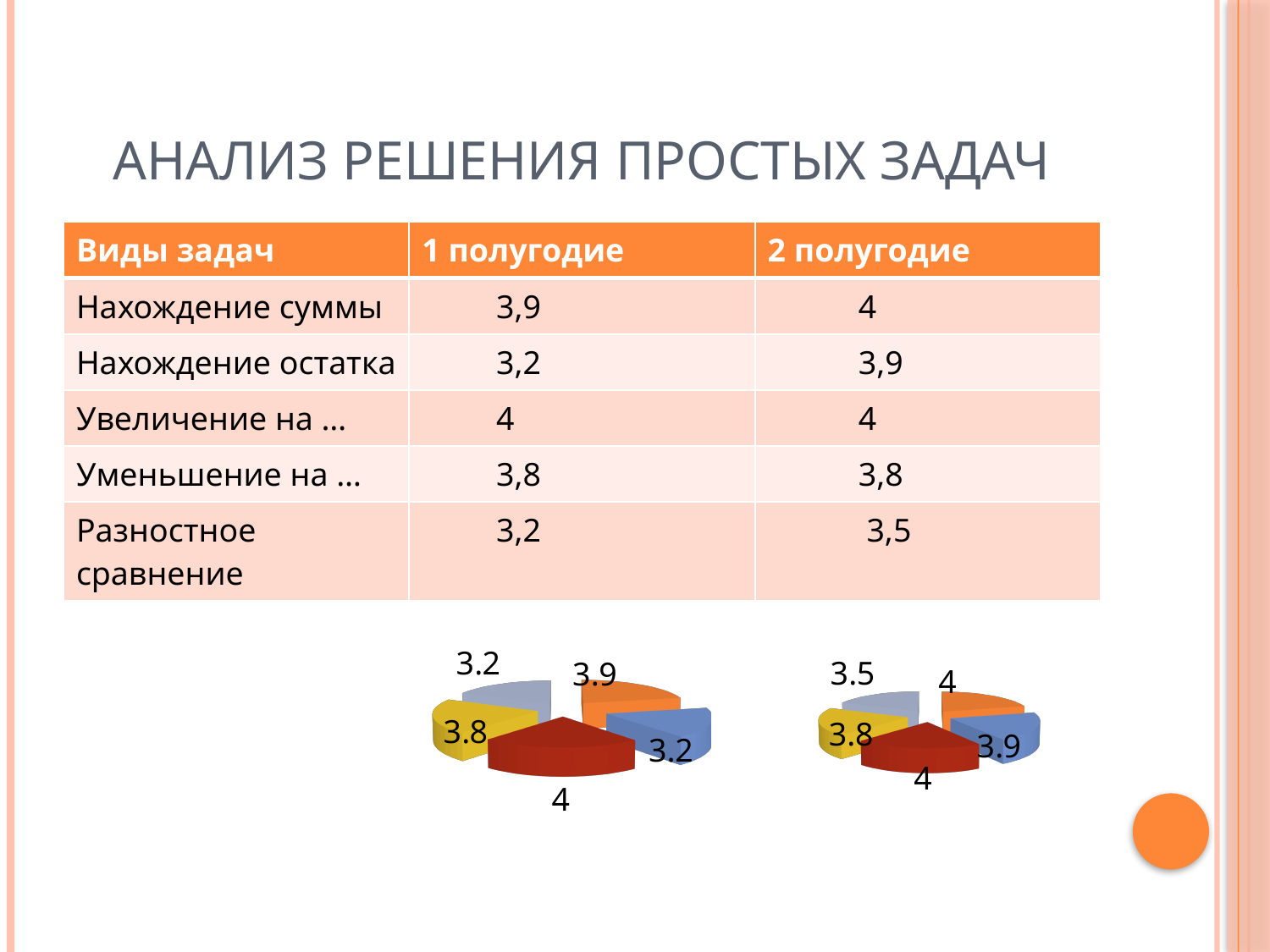
What is the smallest value labeled on the right pie chart? 3.5 How many slices does the right pie chart have? 5 On the right pie chart, what value is labeled on the yellow slice? 3.8 How many pie charts are shown on the slide? 2 On the left pie chart, which slice has the larger value, the orange slice or the blue slice? the orange slice How many slices does the left pie chart have? 5 What is the smallest value labeled on the left pie chart? 3.2 On the right pie chart, what value is labeled on the grey slice? 3.5 On the right pie chart, what is the difference between the largest labeled value and the smallest labeled value? 0.5 What is the largest value labeled on the left pie chart? 4 On the left pie chart, what value is labeled on the red slice? 4 What type of chart is the left chart on the slide? pie chart